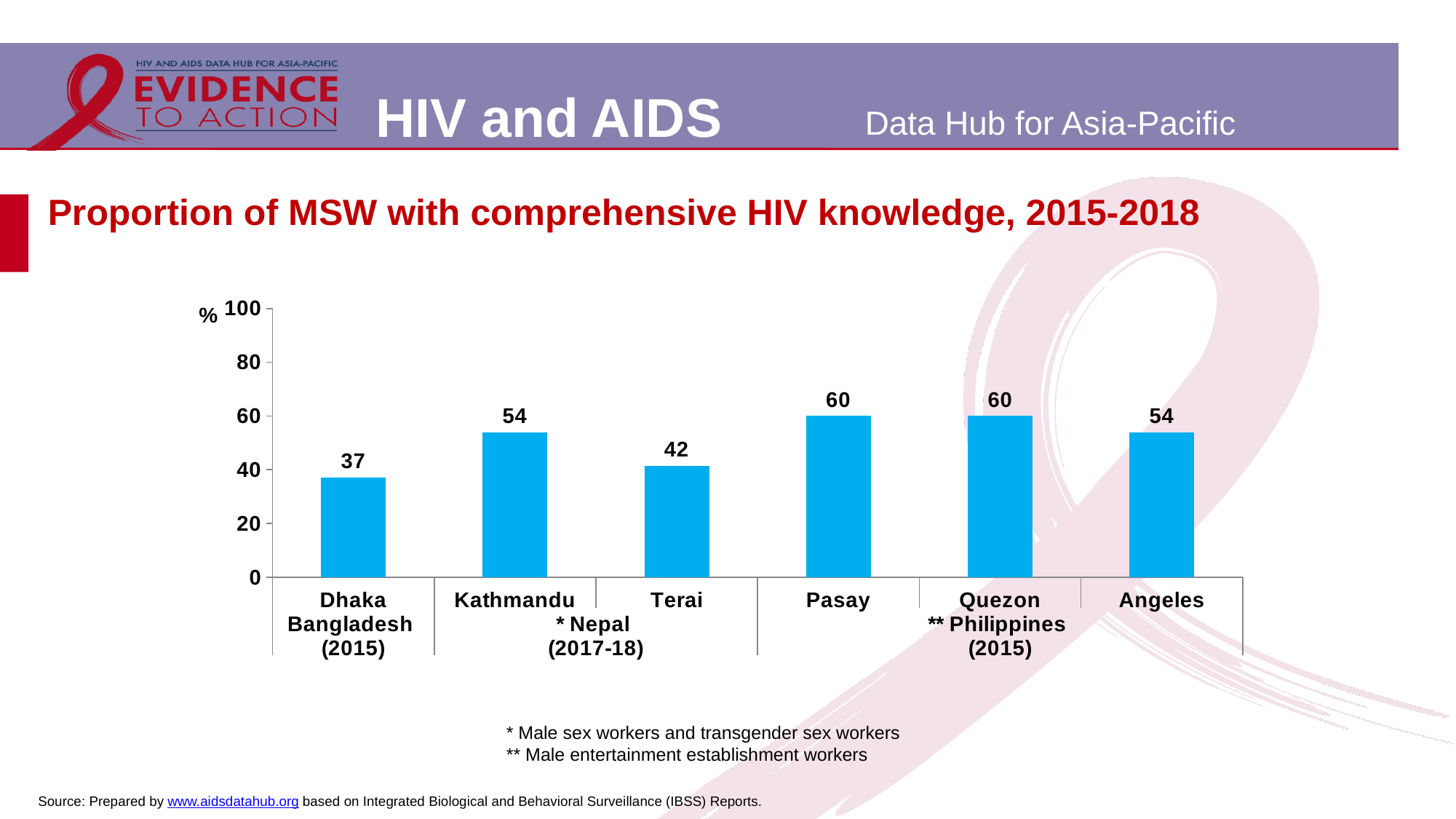
What is the title of the chart? Proportion of MSW with comprehensive HIV knowledge, 2015-2018 What value is shown for Terai? 42 How many cities are shown in the chart? 6 What value is shown for Kathmandu? 54 Is the value for Dhaka greater or less than 40? less What is the difference between the values for Pasay and Dhaka? 23 Which has a higher value, Terai or Angeles? Angeles What value is shown for Pasay? 60 Which city has the lowest proportion of MSW with comprehensive HIV knowledge? Dhaka What type of chart is shown on the slide? Bar chart What is the proportion of MSW with comprehensive HIV knowledge in Dhaka, Bangladesh? 37 What is the difference between the values for Kathmandu and Terai? 12